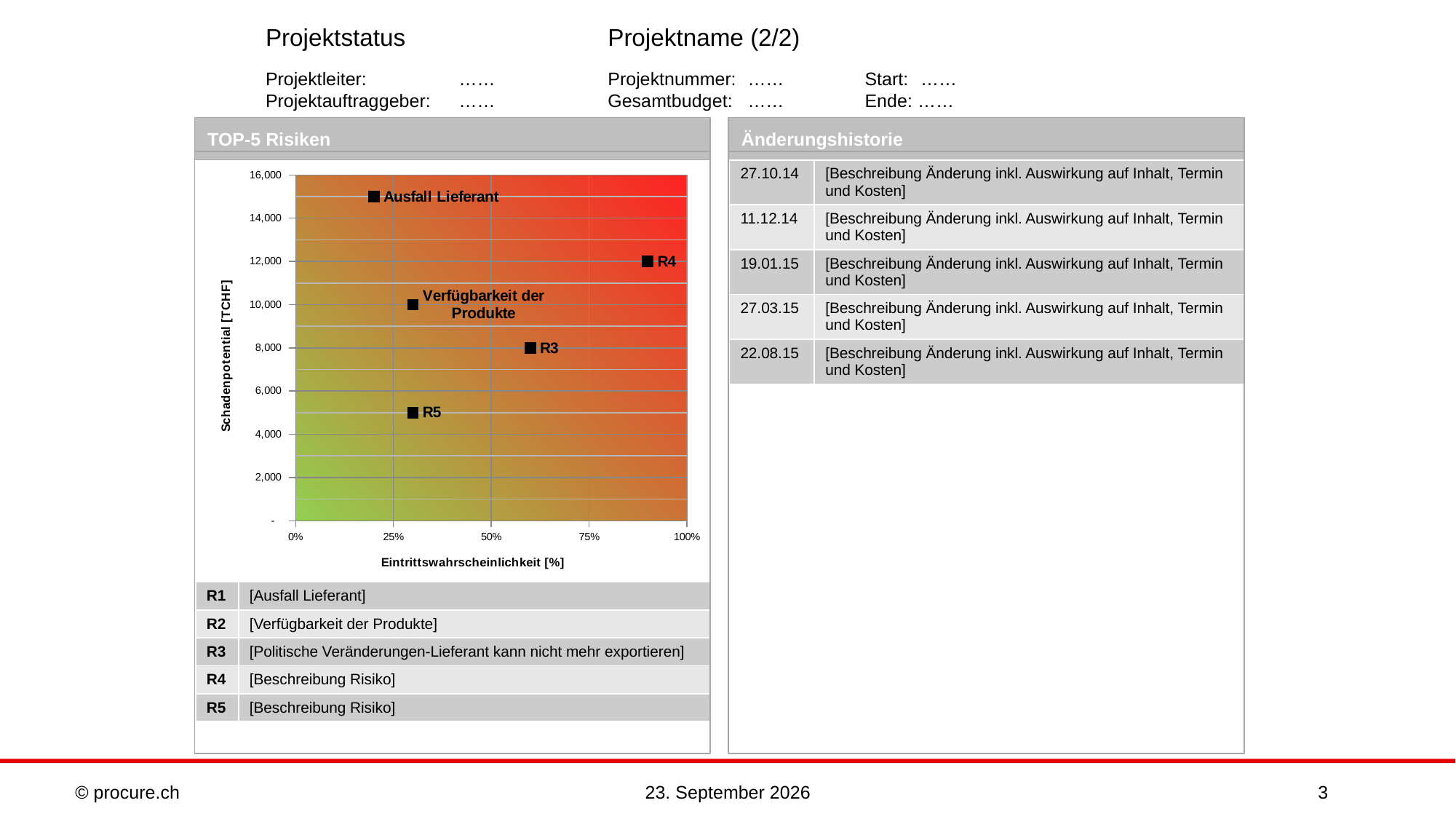
Which has the higher Schadenpotential, R3 or R5? R3 What is the Schadenpotential of R4 in the TOP-5 Risiken chart? 12,000 What kind of chart is shown under "TOP-5 Risiken"? scatter chart Is the Schadenpotential for Ausfall Lieferant greater or less than 14,000? greater Which risk has the highest Eintrittswahrscheinlichkeit in the TOP-5 Risiken chart? R4 Which risk has the highest Schadenpotential in the TOP-5 Risiken chart? Ausfall Lieferant Is the Eintrittswahrscheinlichkeit for Ausfall Lieferant greater or less than 25%? less What is the label of the x axis in the TOP-5 Risiken chart? Eintrittswahrscheinlichkeit [%] Which risk has the lowest Schadenpotential in the TOP-5 Risiken chart? R5 What is the Schadenpotential of R3 in the TOP-5 Risiken chart? 8,000 Is the Eintrittswahrscheinlichkeit for R4 greater or less than 75%? greater How many risk points are plotted in the TOP-5 Risiken chart? 5